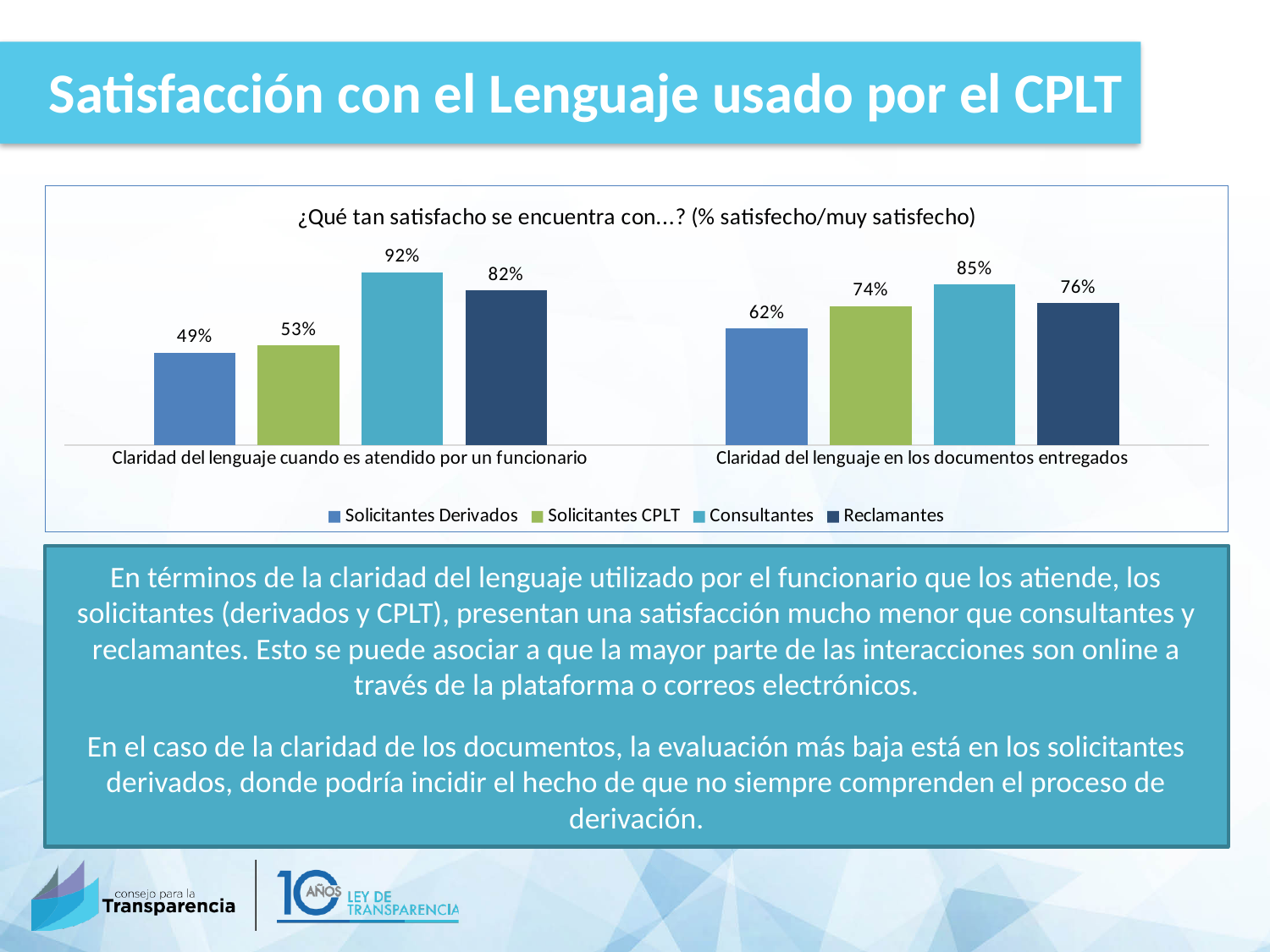
What is the difference between the Consultantes and Reclamantes values in the category 'Claridad del lenguaje en los documentos entregados'? 9% What is the value for Reclamantes in the category 'Claridad del lenguaje cuando es atendido por un funcionario'? 82% What is the difference between the Consultantes and Solicitantes Derivados values in the category 'Claridad del lenguaje cuando es atendido por un funcionario'? 43% What kind of chart is shown on the slide? Bar chart Which series has the highest value in the category 'Claridad del lenguaje en los documentos entregados'? Consultantes What is the value for Solicitantes CPLT in the category 'Claridad del lenguaje en los documentos entregados'? 74% How many series does the legend list? 4 Which is larger for Reclamantes: the value for 'Claridad del lenguaje cuando es atendido por un funcionario' or for 'Claridad del lenguaje en los documentos entregados'? Claridad del lenguaje cuando es atendido por un funcionario What is the value for Solicitantes Derivados in the category 'Claridad del lenguaje en los documentos entregados'? 62% Which series has the lowest value in the category 'Claridad del lenguaje cuando es atendido por un funcionario'? Solicitantes Derivados How many categories are shown on the x axis? 2 What is the value for Consultantes in the category 'Claridad del lenguaje cuando es atendido por un funcionario'? 92%